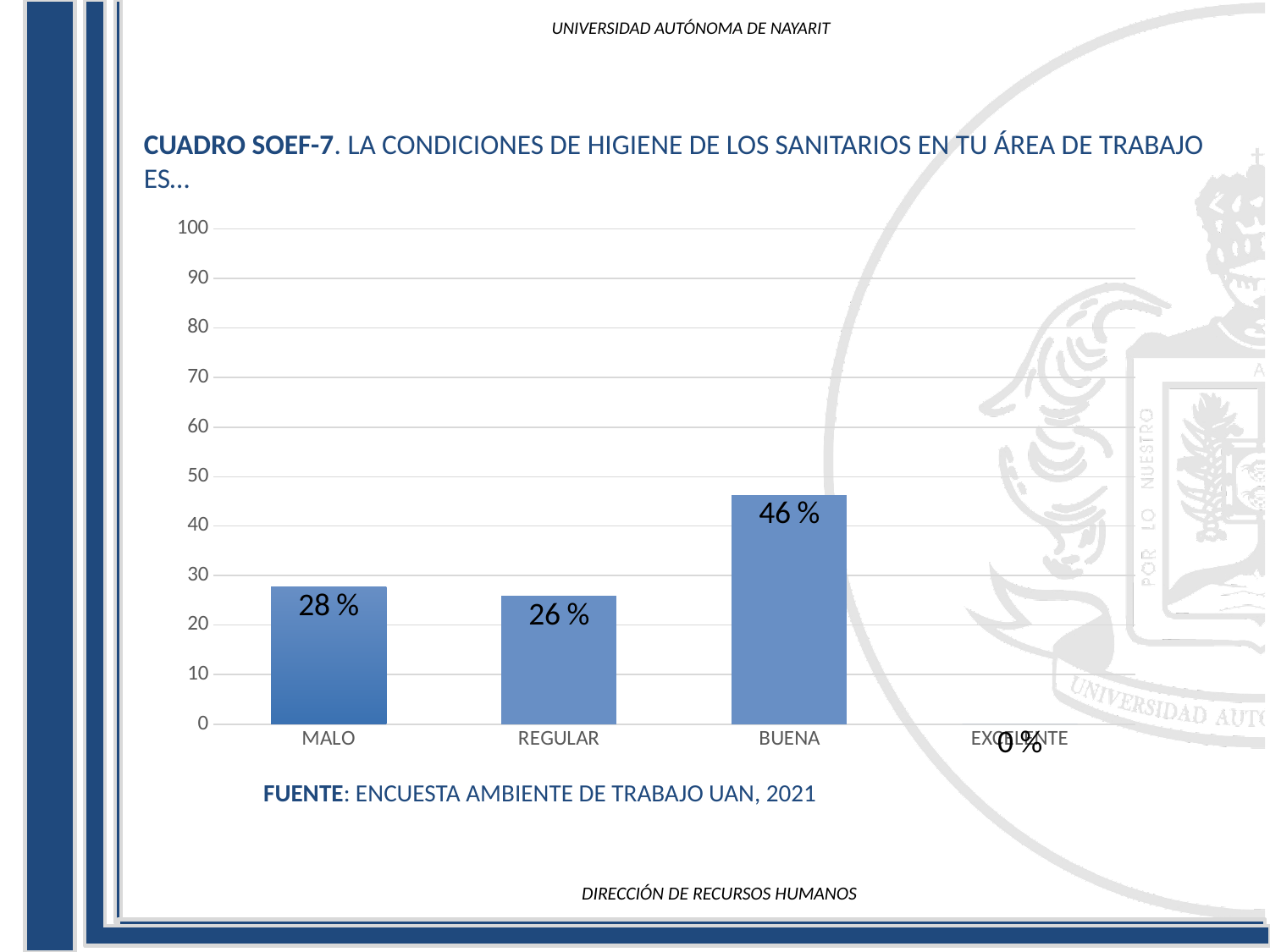
What is the difference between the values for BUENA and MALO? 18 % Which category has the lowest value? EXCELENTE What is the value for MALO? 28 % Which category has the highest value? BUENA What source is cited below the chart? ENCUESTA AMBIENTE DE TRABAJO UAN, 2021 Which is larger, the value for MALO or the value for REGULAR? MALO What is the value for EXCELENTE? 0 % What is the value for REGULAR? 26 % What kind of chart is shown on the slide? bar chart Is the value for BUENA greater or less than 40? greater How many categories are shown on the x axis? 4 What is the value for BUENA? 46 %